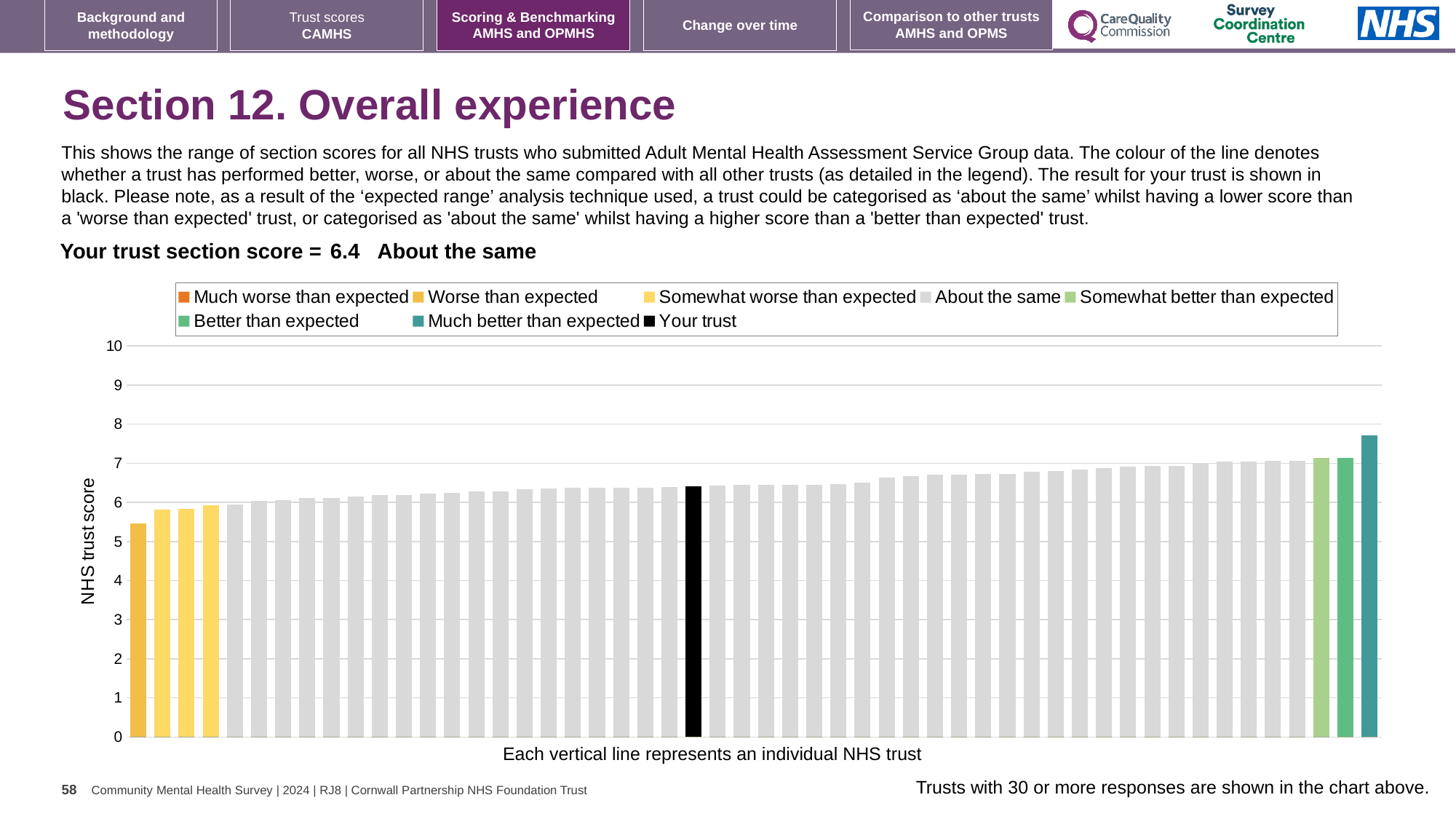
Is the value of the black 'Your trust' bar greater or less than 6? greater Which legend category does the shortest bar belong to? Worse than expected Do the bar values rise or fall from left to right along the x axis? rise What is the label on the vertical axis of the chart? NHS trust score Is the value of the leftmost (lowest) bar greater or less than 6? less How many entries does the chart legend list? 8 Which legend category does the tallest bar belong to? Much better than expected Which category is your trust placed in according to the slide? About the same What is the section score for your trust shown on the slide? 6.4 How many bars are coloured as 'Somewhat better than expected'? 1 What kind of chart is shown on the slide? bar chart Is the value of the rightmost (highest) bar greater or less than 7? greater